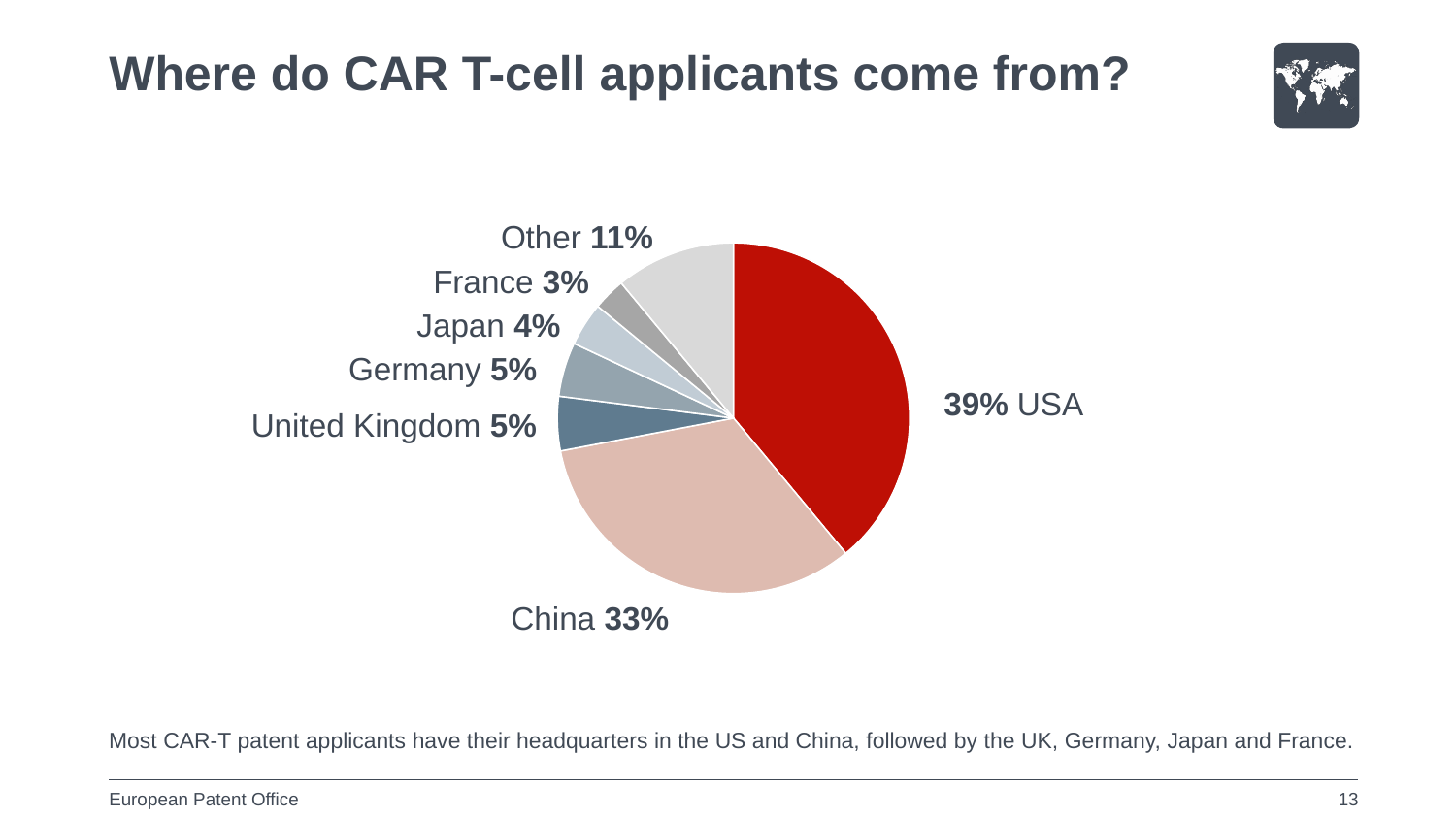
What share of CAR T-cell applicants come from China? 33% Which has a larger share, Germany or Japan? Germany What share of CAR T-cell applicants come from France? 3% What type of chart is shown on the slide? Pie chart What is the difference in percentage points between the USA and China shares? 6 Which named country has the smallest share of CAR T-cell applicants? France What share of CAR T-cell applicants come from the USA? 39% How many slices does the pie chart have? 7 What is the title of the slide containing the chart? Where do CAR T-cell applicants come from? What share of CAR T-cell applicants come from Japan? 4% What share of CAR T-cell applicants fall under 'Other'? 11% Which country has the largest share of CAR T-cell applicants? USA